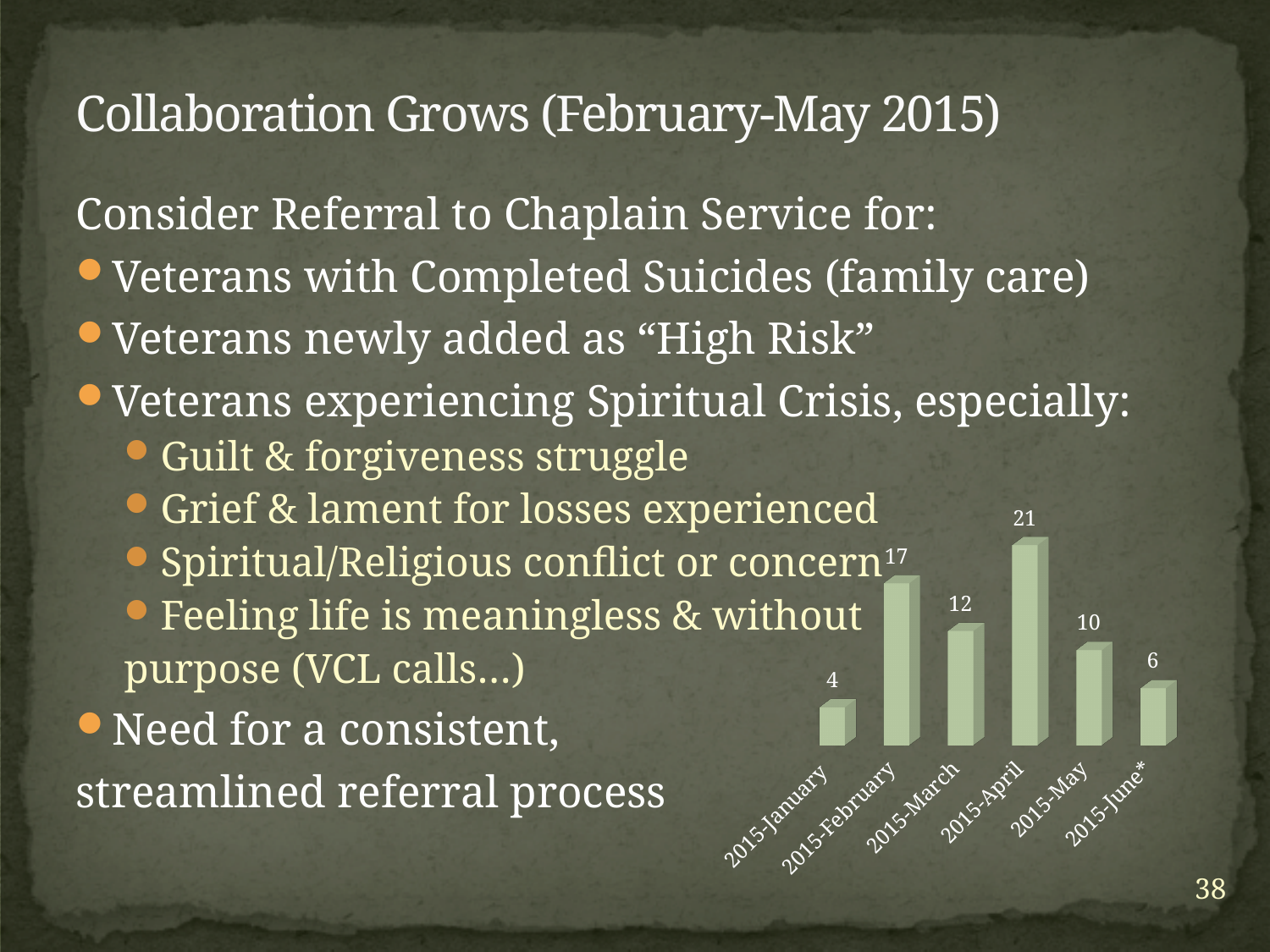
Which month has the lowest value? 2015-January Do the values rise or fall from 2015-April to 2015-June*? fall What is the value for 2015-May? 10 Which is larger, the value for 2015-February or the value for 2015-May? 2015-February What is the difference between the values for 2015-April and 2015-March? 9 What is the value for 2015-April? 21 What is the value for 2015-June*? 6 What kind of chart is shown on the slide? bar chart Which month has the highest value? 2015-April What is the difference between the values for 2015-February and 2015-January? 13 How many months are shown in the chart? 6 What is the value for 2015-January? 4